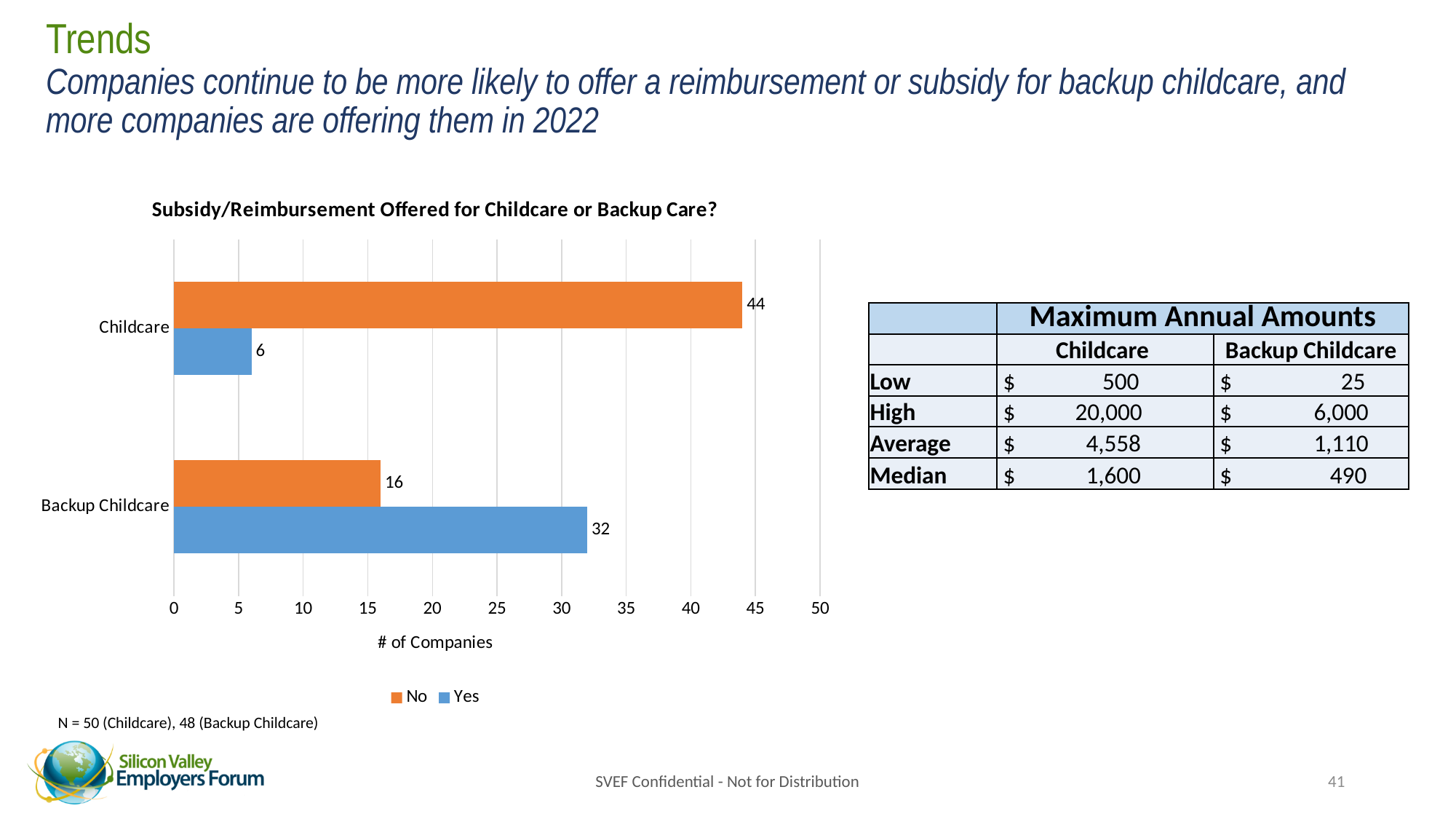
How many companies answered "Yes" for Childcare? 6 How many companies answered "Yes" for Backup Childcare? 32 What is the difference between the "No" and "Yes" values for Childcare? 38 How many series does the legend list? 2 What is the difference between the "Yes" and "No" values for Backup Childcare? 16 Is the "No" value for Backup Childcare larger or smaller than the "Yes" value for Backup Childcare? smaller What is the title of the chart? Subsidy/Reimbursement Offered for Childcare or Backup Care? How many companies answered "No" for Backup Childcare? 16 Which category has the higher "Yes" value? Backup Childcare Which category has the lower "No" value? Backup Childcare How many companies answered "No" for Childcare? 44 What kind of chart is shown on the slide? bar chart